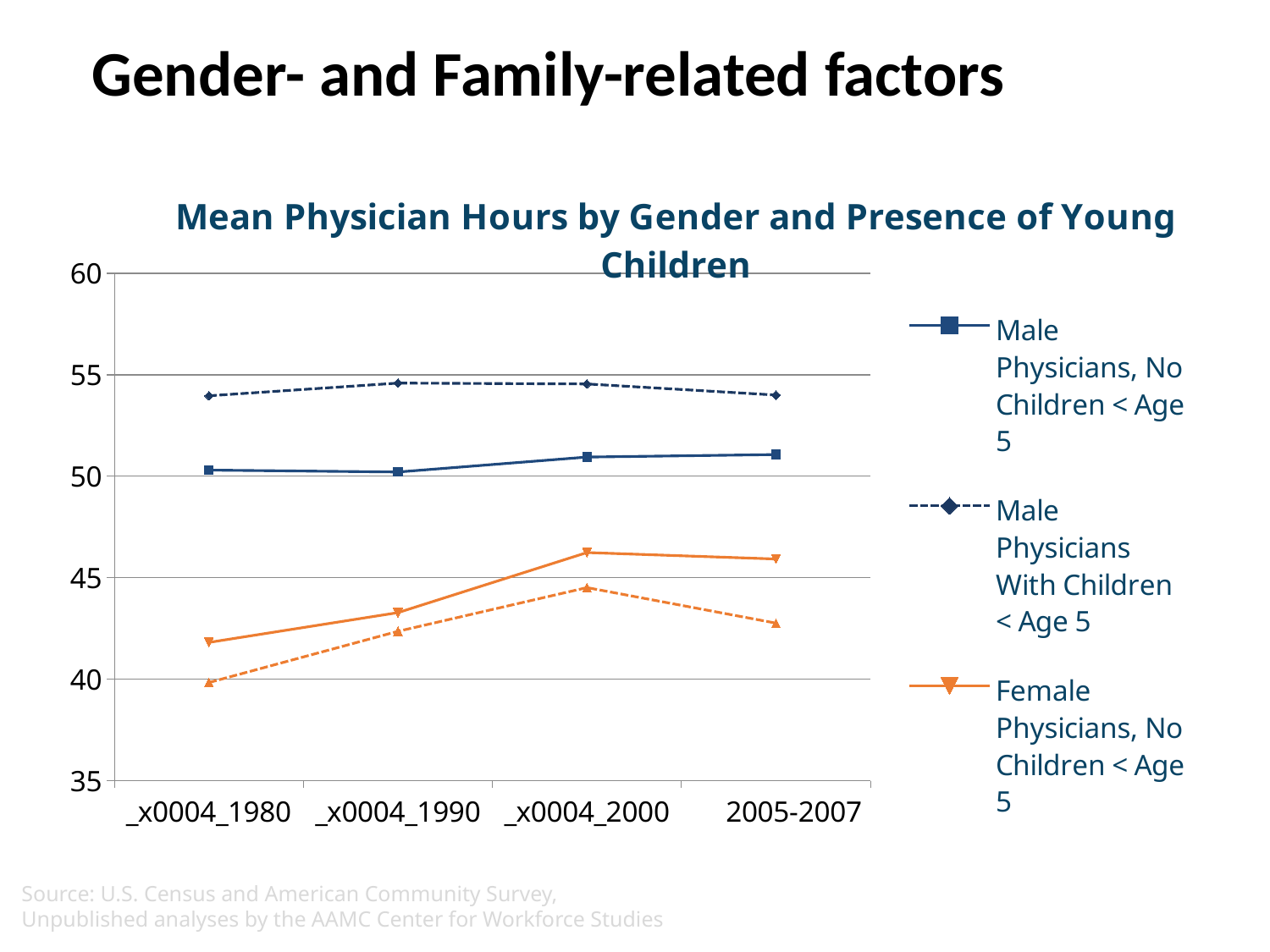
Is the value for Female Physicians, No Children < Age 5 in 2005-2007 greater or less than 45? greater Is the value for Male Physicians With Children < Age 5 in _x0004_1980 greater or less than 55? less Is the value for Male Physicians, No Children < Age 5 in _x0004_2000 greater or less than 50? greater In _x0004_1990, which is larger: Male Physicians With Children < Age 5 or Male Physicians, No Children < Age 5? Male Physicians With Children < Age 5 How many series does the chart's legend list? 3 What is the title of the chart? Mean Physician Hours by Gender and Presence of Young Children Do the values for Female Physicians, No Children < Age 5 rise or fall from _x0004_1980 to _x0004_2000? rise Which series has the highest values across all periods? Male Physicians With Children < Age 5 How many time periods are shown along the x axis? 4 What is the label of the last period on the x axis? 2005-2007 What kind of chart is shown on the slide? line chart